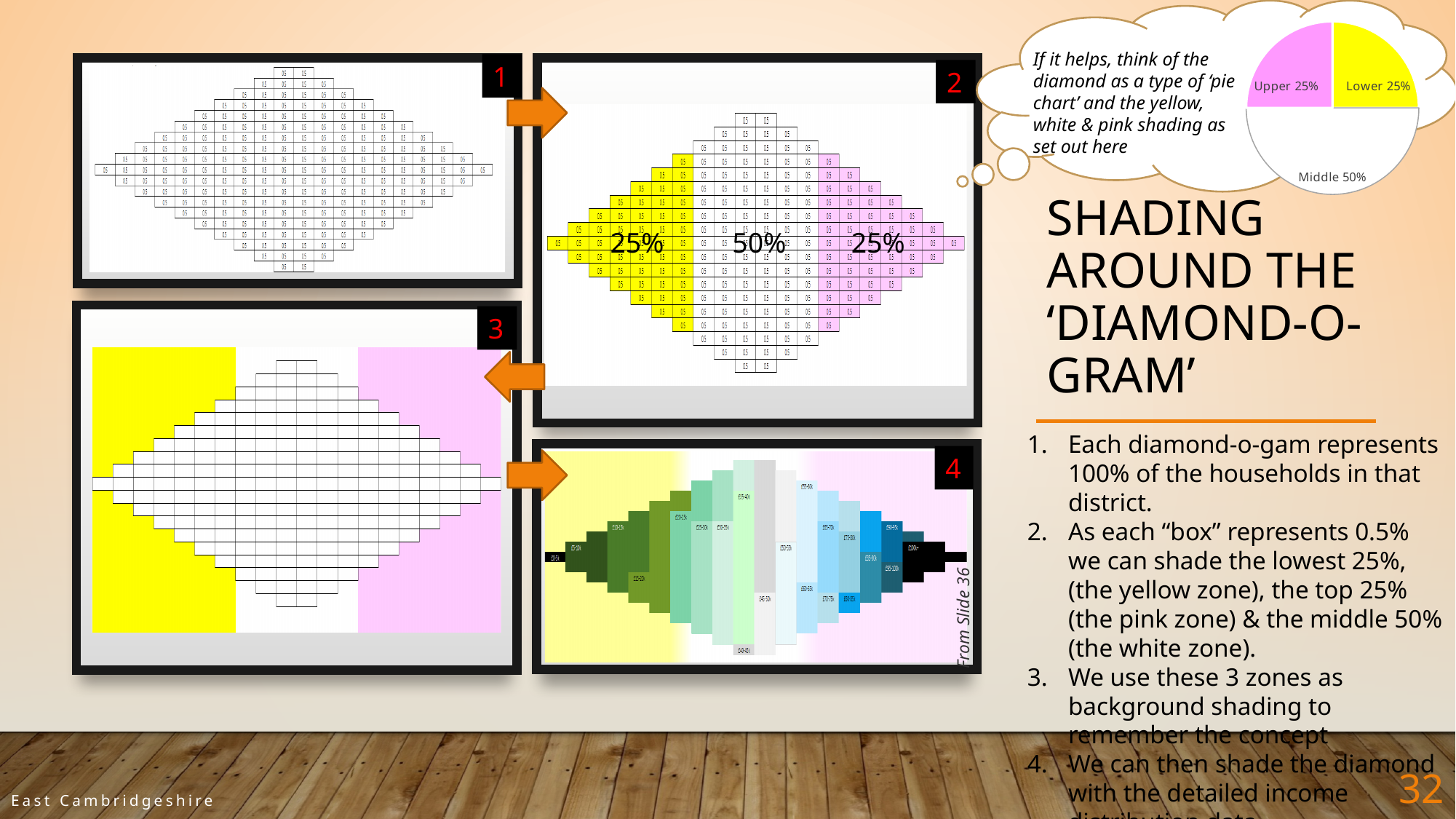
In the pie chart in the thought bubble, which slice is the largest? Middle 50% In the pie chart in the thought bubble, what colour is the Upper 25% slice? pink In the pie chart in the thought bubble, what share does the Upper slice represent? 25% What kind of chart is shown in the thought bubble at the top right of the slide? pie chart In the pie chart in the thought bubble, what share does the Lower slice represent? 25% In the pie chart in the thought bubble, what colour is the Lower 25% slice? yellow In the diamond-o-gram labelled 2, what percentage is printed over the yellow zone? 25% In the pie chart in the thought bubble, what is the difference between the Middle share and the Lower share? 25% In the pie chart in the thought bubble, what share does the Middle slice represent? 50% How many slices does the pie chart in the thought bubble have? 3 In the pie chart in the thought bubble, is the Middle slice larger or smaller than the Upper slice? larger In the diamond-o-gram labelled 2, what percentage is printed over the white middle zone? 50%